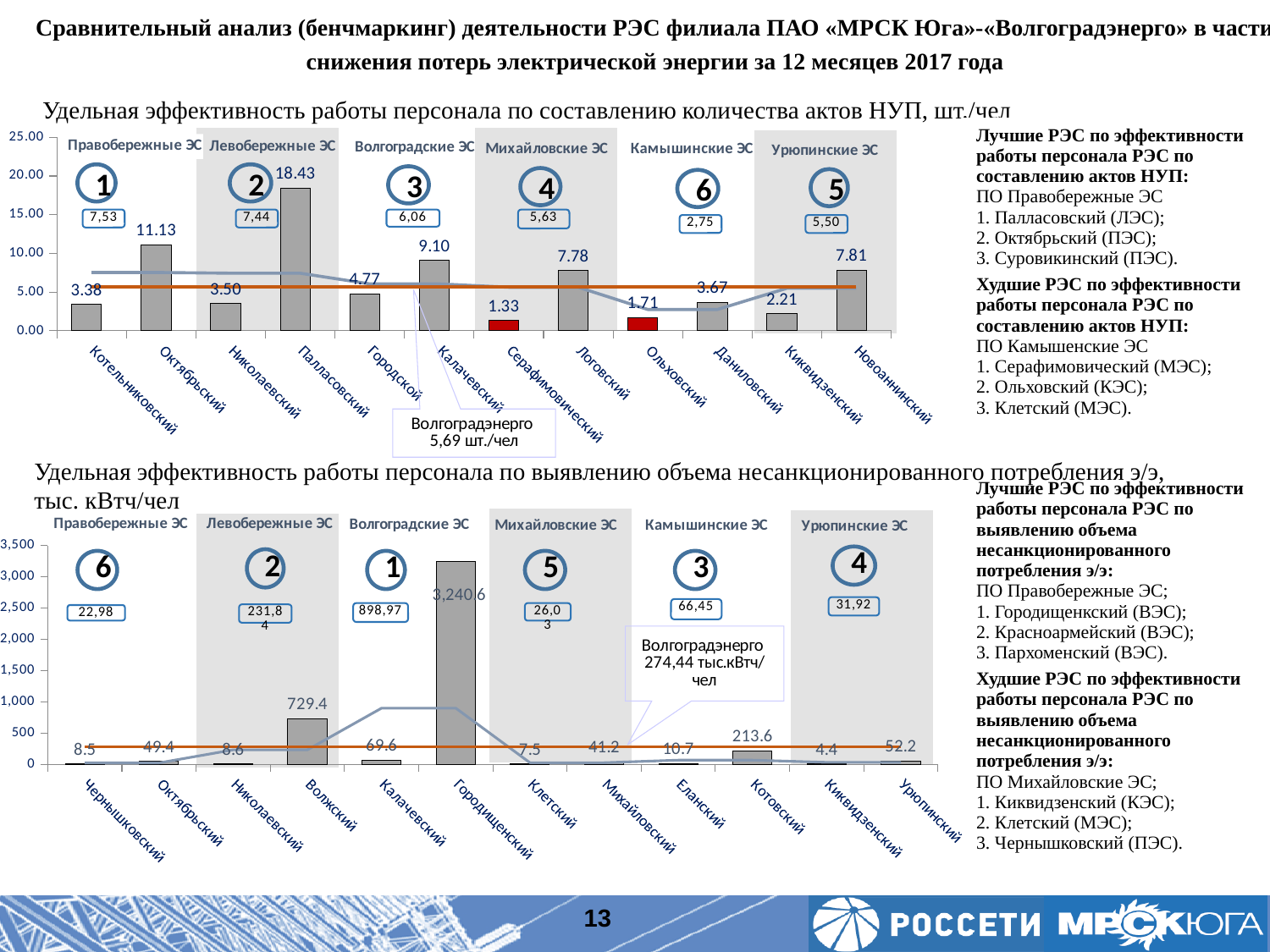
In the top chart (составление актов НУП), what value is shown in the callout for Волгоградэнерго? 5,69 шт./чел In the top chart (составление актов НУП), which category has the highest value? Палласовский In the bottom chart (выявление объема несанкционированного потребления), what is the value for Городищенский? 3,240.6 In the top chart (составление актов НУП), how many categories are plotted on the x axis? 12 In the top chart (составление актов НУП), what is the difference between Октябрьский and Котельниковский? 7.75 In the top chart (составление актов НУП), what is the value for Палласовский? 18.43 In the top chart (составление актов НУП), which is larger: Калачевский or Логовский? Калачевский In the top chart (составление актов НУП), which category has the lowest value? Серафимовический In the bottom chart (выявление объема несанкционированного потребления), which category has the highest value? Городищенский In the bottom chart (выявление объема несанкционированного потребления), which is larger: Октябрьский or Урюпинский? Урюпинский In the bottom chart (выявление объема несанкционированного потребления), what is the difference between Волжский and Котовский? 515.8 What type of chart is the bottom chart (выявление объема несанкционированного потребления)? Combination bar and line chart